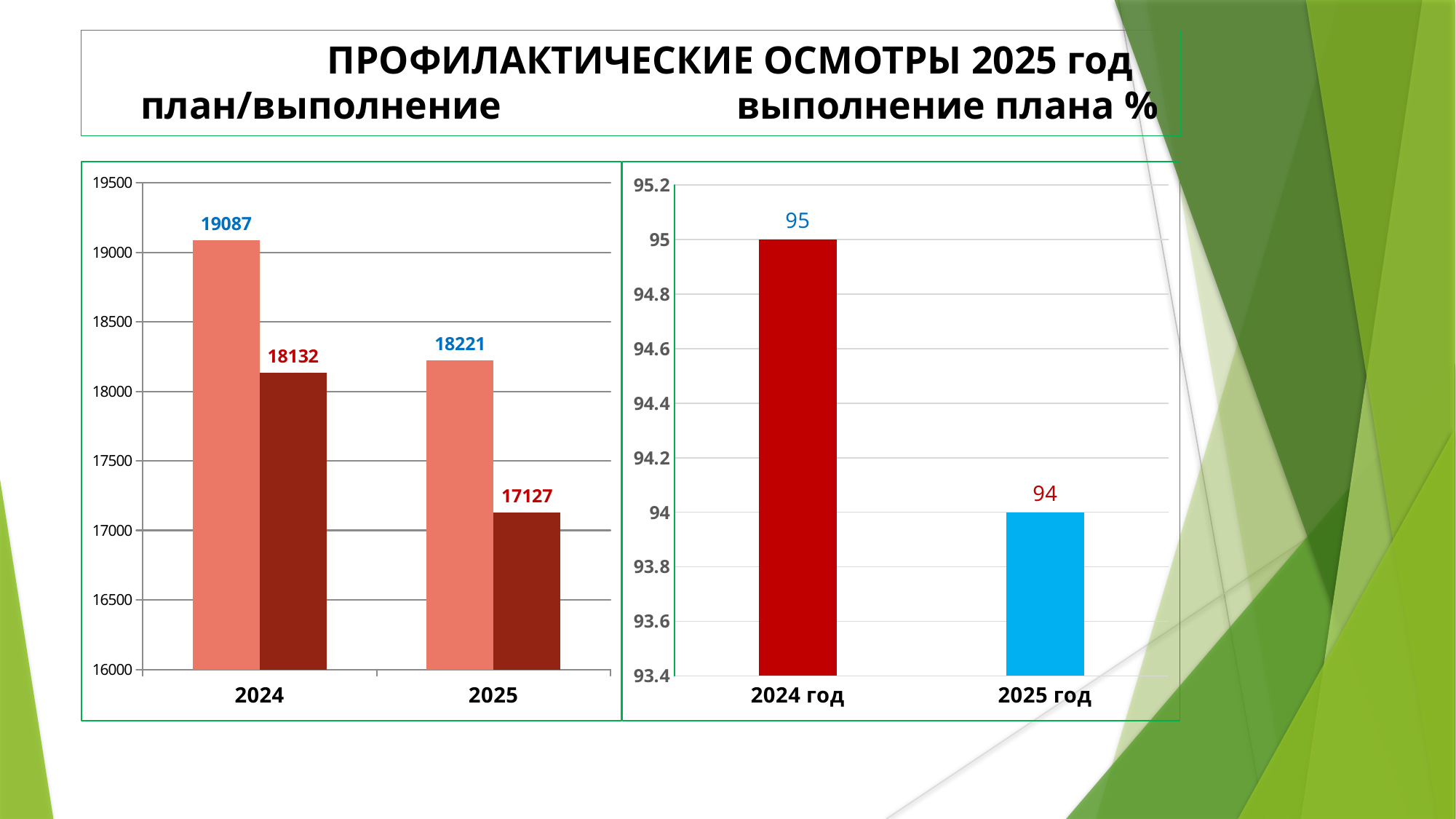
In the left chart (план/выполнение), what is the value of the shorter (execution) bar for 2025? 17127 In the left chart (план/выполнение), how many year categories are shown on the x axis? 2 In the left chart (план/выполнение), do the plan values rise or fall from 2024 to 2025? fall In the right chart (выполнение плана %), which category has the lowest value? 2025 год In the left chart (план/выполнение), what is the difference between the plan and execution values for 2024? 955 In the right chart (выполнение плана %), what colour is the bar for 2025 год? blue In the left chart (план/выполнение), what is the value of the taller (plan) bar for 2024? 19087 What kind of chart is the right chart (выполнение плана %)? bar chart In the left chart (план/выполнение), which year has the higher execution value, 2024 or 2025? 2024 In the right chart (выполнение плана %), what is the value for 2024 год? 95 In the right chart (выполнение плана %), what is the value for 2025 год? 94 In the left chart (план/выполнение), what is the difference between the plan values for 2024 and 2025? 866